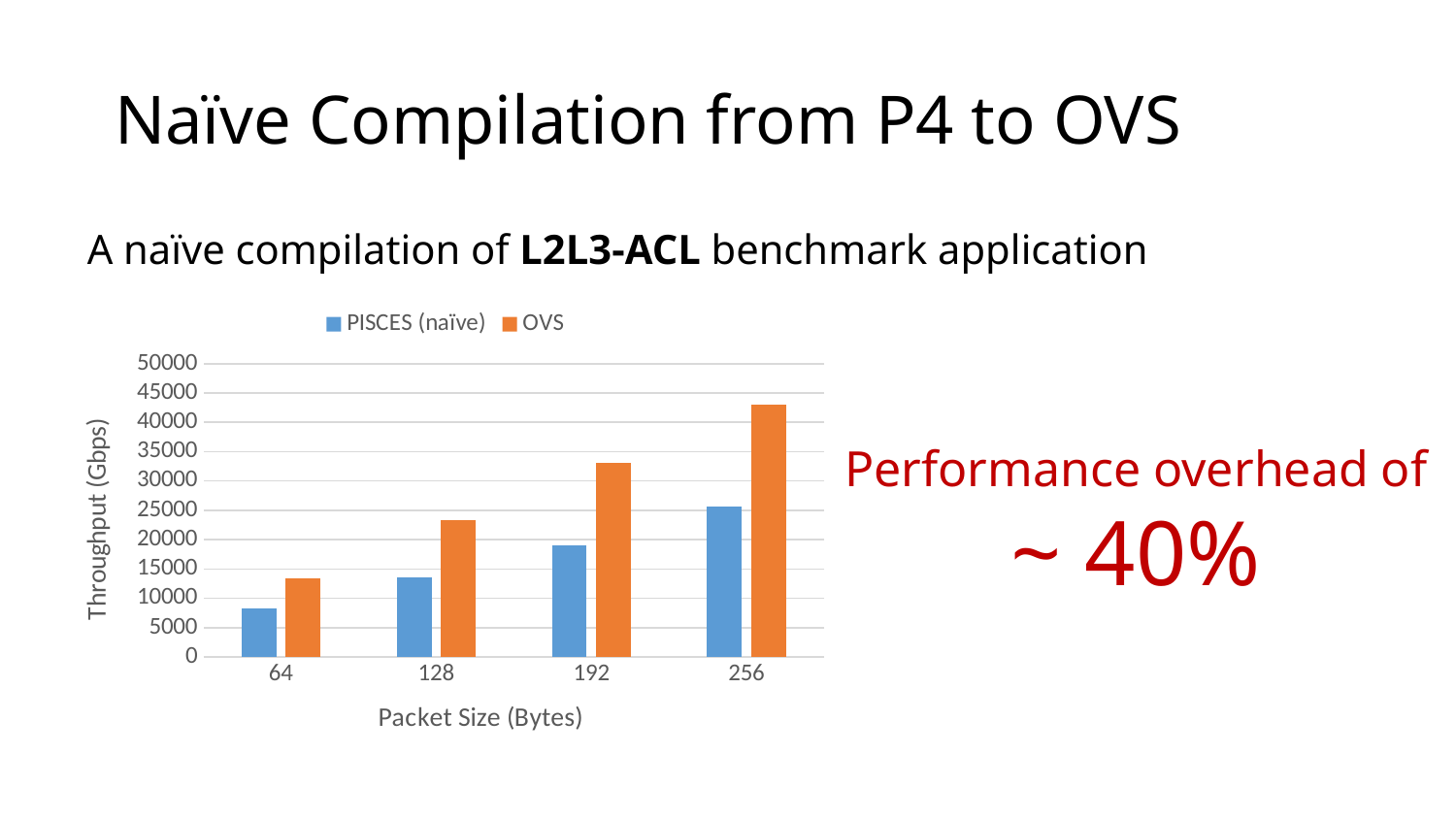
Is the OVS throughput at packet size 192 greater or less than 30000? greater How many series does the legend list? 2 At packet size 192, which series has the higher throughput, PISCES (naïve) or OVS? OVS Which packet size has the highest OVS throughput? 256 Does the OVS throughput rise or fall as packet size increases along the x axis? rise What kind of chart is shown on the slide? bar chart Is the OVS throughput at packet size 256 greater or less than 40000? greater Is the PISCES (naïve) throughput at packet size 256 greater or less than 20000? greater How many packet size categories are shown on the x axis? 4 Which packet size has the lowest PISCES (naïve) throughput? 64 What is the label of the y axis? Throughput (Gbps)